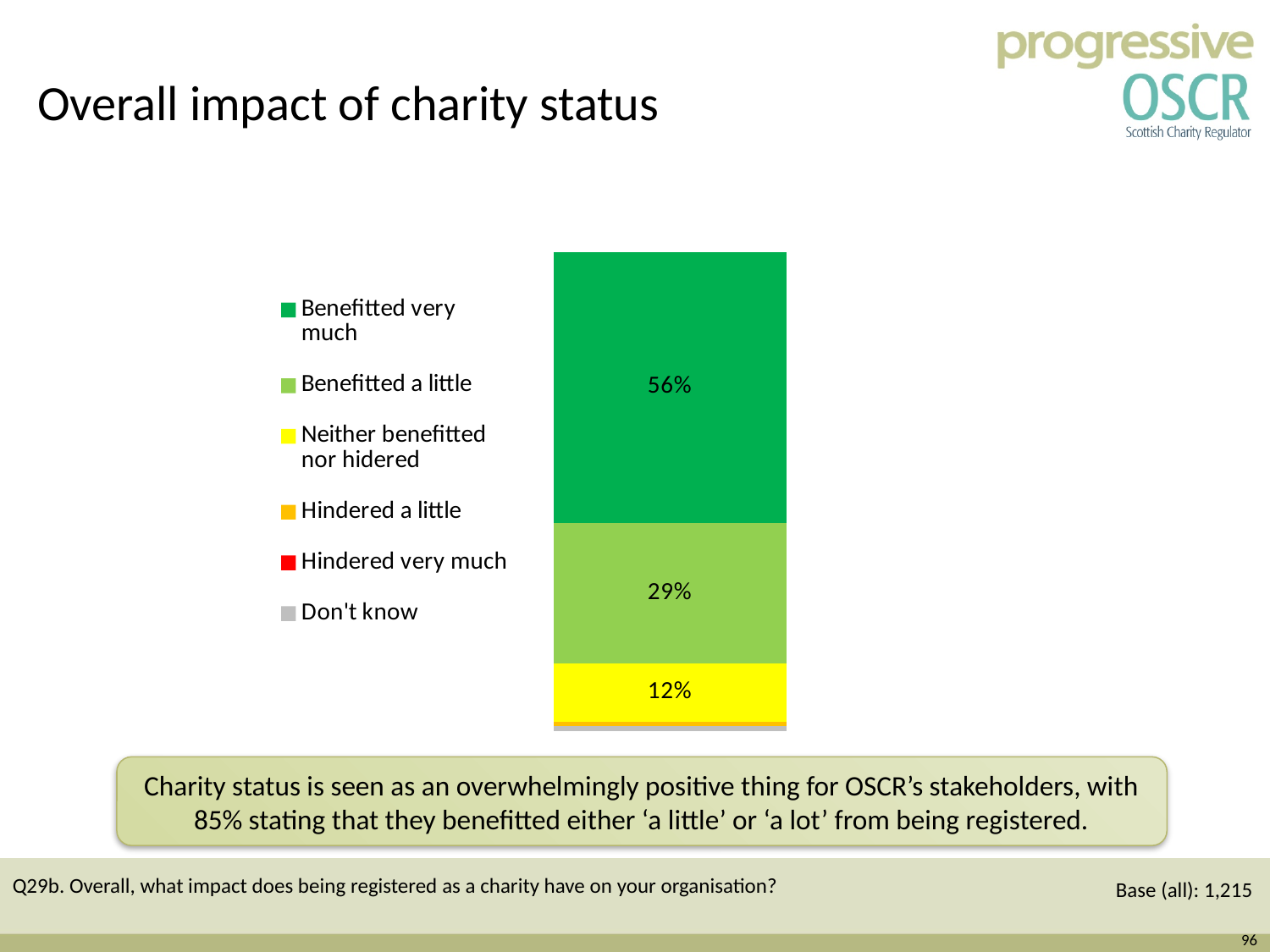
What kind of chart is shown on the slide? Stacked bar chart What is the difference between the 'Benefitted a little' and 'Neither benefitted nor hindered' percentages? 17 percentage points What is the difference between the 'Benefitted very much' and 'Benefitted a little' percentages? 27 percentage points How many response categories does the legend list? 6 What colour represents 'Benefitted very much' in the legend? Dark green What percentage of respondents said charity status 'Benefitted a little'? 29% What percentage of respondents said charity status 'Neither benefitted nor hindered'? 12% What percentage of respondents said charity status 'Benefitted very much'? 56% What is the combined percentage of 'Benefitted very much' and 'Benefitted a little'? 85% Which response category has the largest segment in the stacked bar? Benefitted very much What is the title of the slide containing the chart? Overall impact of charity status Which is larger: the 'Benefitted a little' segment or the 'Neither benefitted nor hindered' segment? Benefitted a little